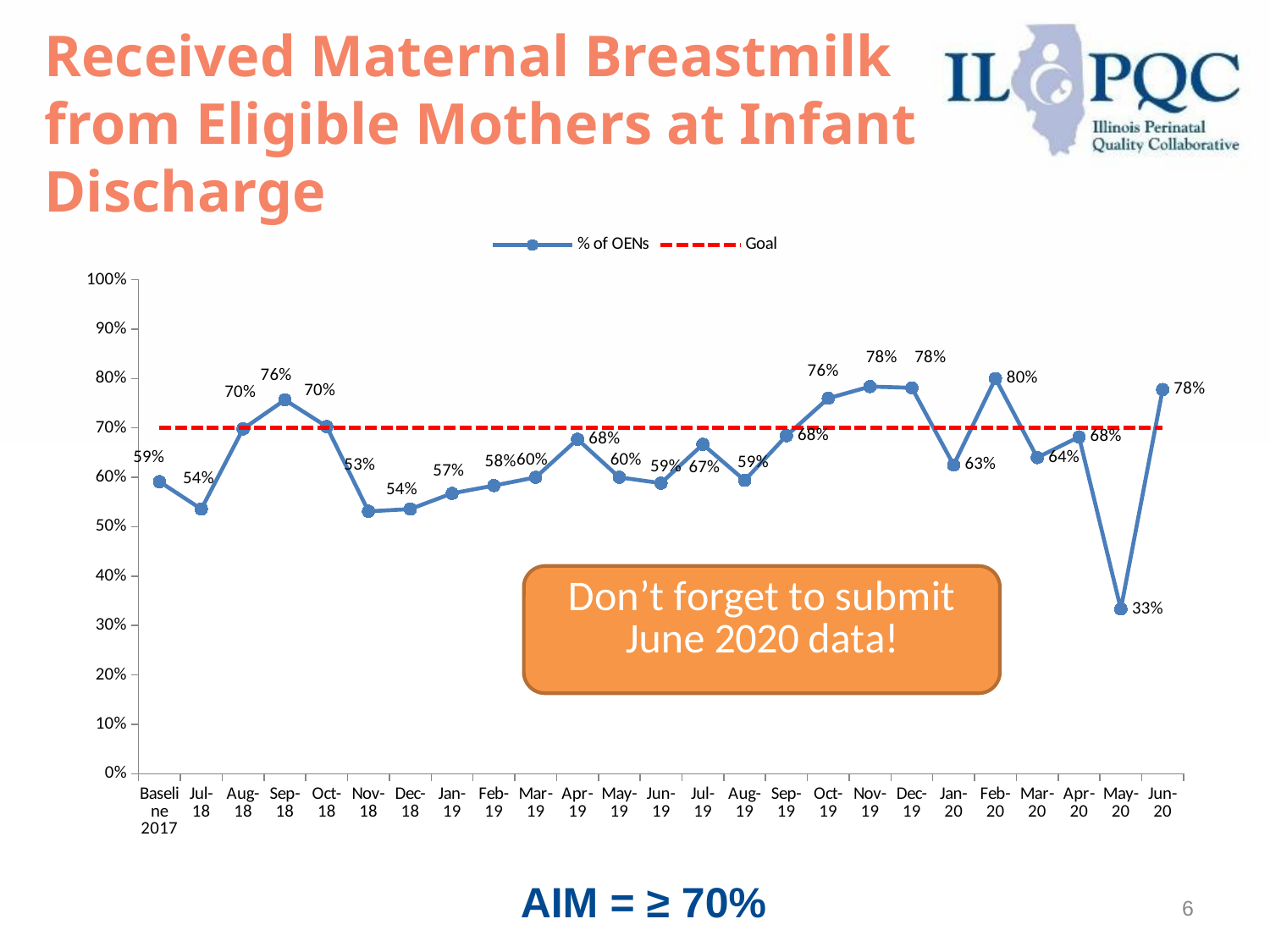
What is the % of OENs value for Sep-18? 76% Is the % of OENs value for Nov-18 greater or less than 60%? less Which month has the highest % of OENs? Feb-20 What kind of chart is shown on the slide? Line chart At what value is the Goal line drawn? 70% Which month has the lowest % of OENs? May-20 How many data points are plotted on the % of OENs line? 25 What is the difference between the % of OENs for Feb-20 and May-20? 47 percentage points How many series does the legend list? 2 What is the % of OENs value for May-20? 33% Which has a higher % of OENs, Oct-19 or Jan-20? Oct-19 What is the % of OENs value for Baseline 2017? 59%